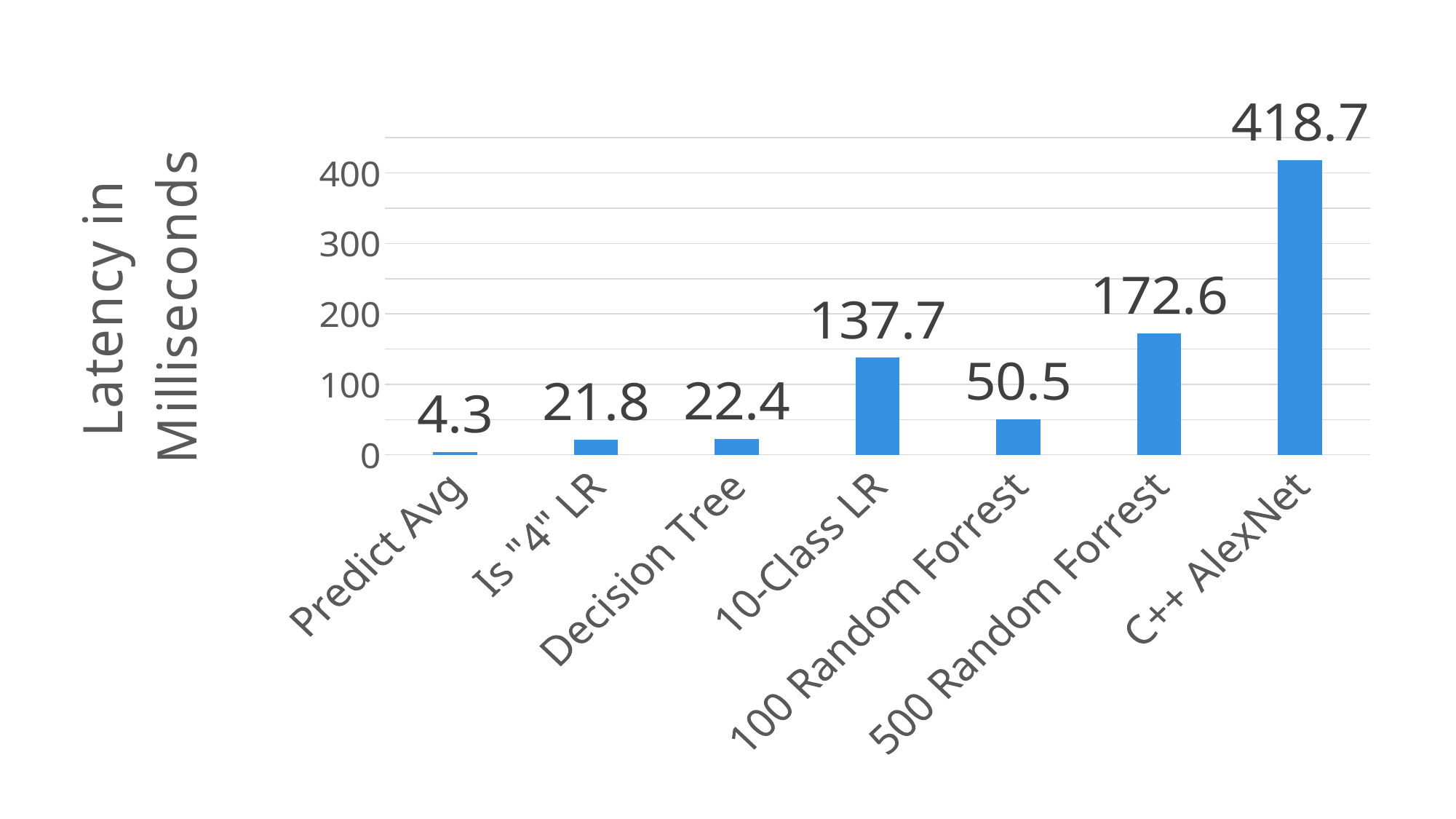
What is the difference in latency between 500 Random Forrest and 100 Random Forrest? 122.1 What is the latency in milliseconds for C++ AlexNet? 418.7 What kind of chart is shown on the slide? Bar chart What is the latency in milliseconds for 10-Class LR? 137.7 What is the label of the vertical axis? Latency in Milliseconds Which category has the lowest latency? Predict Avg How many categories are shown on the x axis? 7 Which category has the highest latency? C++ AlexNet Which has a higher latency, 500 Random Forrest or 10-Class LR? 500 Random Forrest What is the latency in milliseconds for 100 Random Forrest? 50.5 What is the difference in latency between C++ AlexNet and 10-Class LR? 281.0 What is the latency in milliseconds for Predict Avg? 4.3